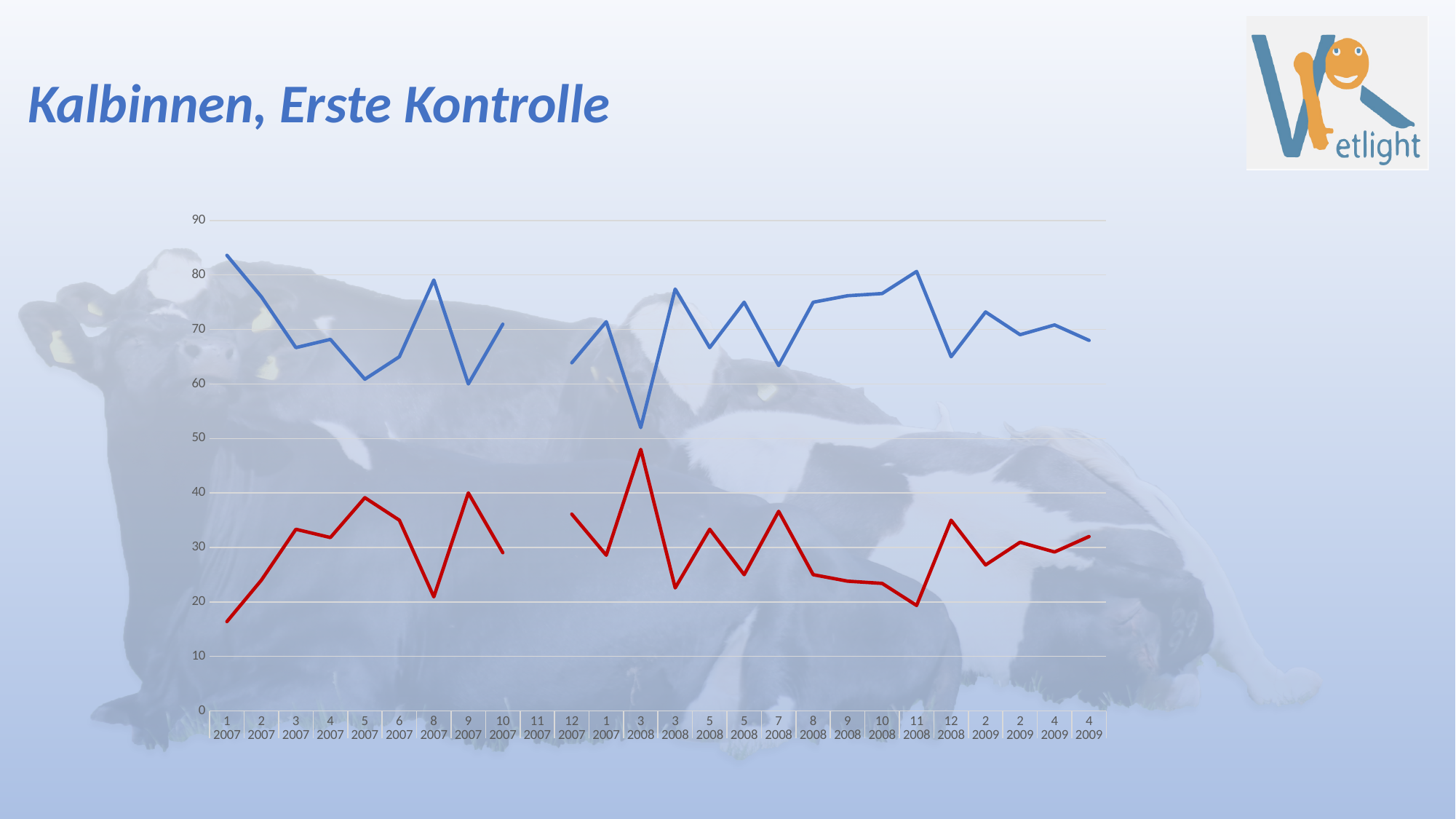
At which x-axis category does the red line reach its highest value? 3 2008 What colours are the two lines in the chart? blue and red What kind of chart is shown on the slide? line chart Which line has the larger value at 1 2007, the blue line or the red line? blue line How many categories are shown along the x axis of the chart? 26 How many lines are plotted in the chart? 2 Is the value of the blue line at 1 2007 greater or less than 80? greater What is the title of the slide containing the chart? Kalbinnen, Erste Kontrolle Is the lowest value of the blue line, at 3 2008, greater or less than 60? less At which x-axis category does the blue line reach its lowest value? 3 2008 Is the value of the red line at 3 2008 (its peak) greater or less than 40? greater